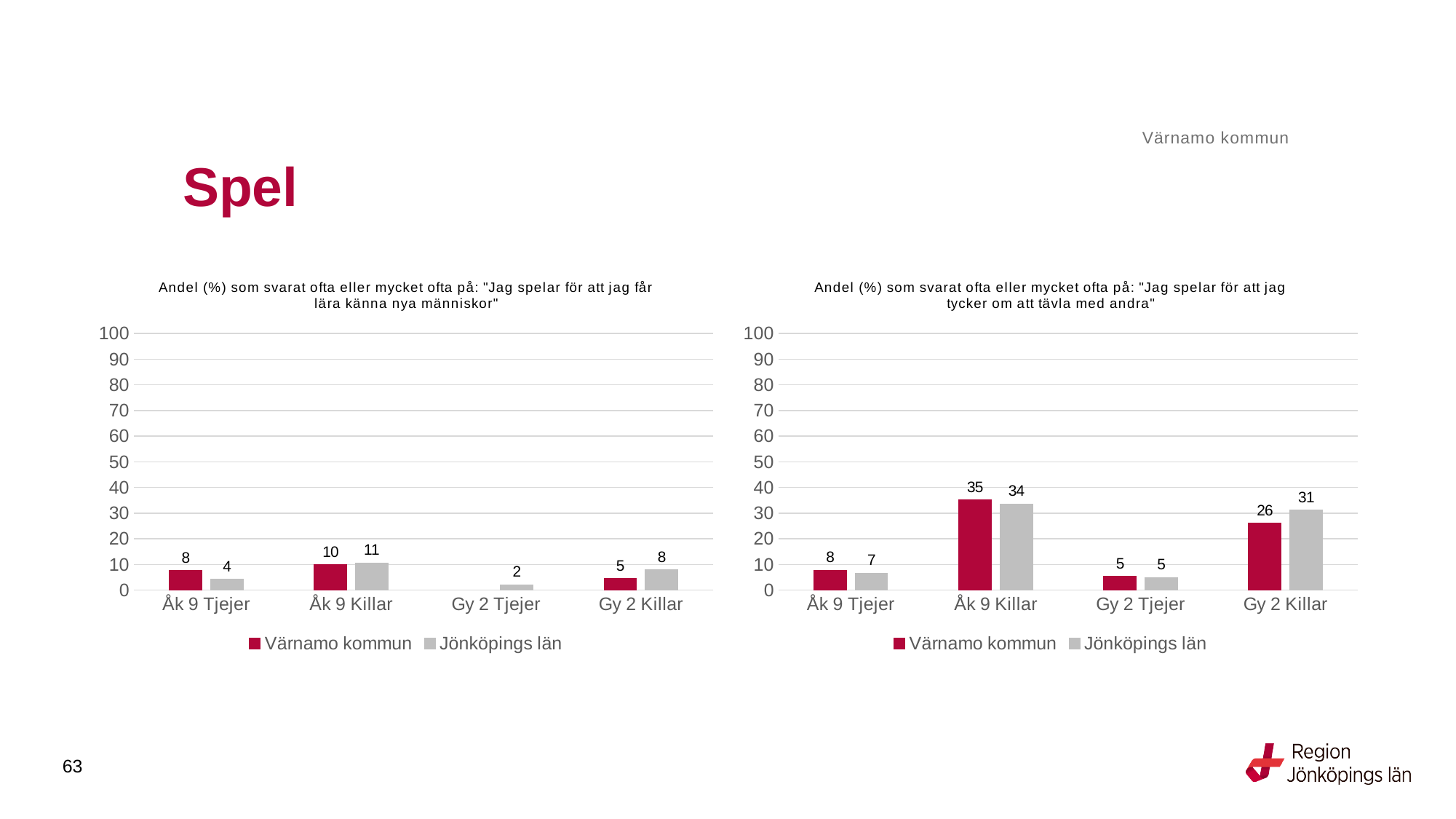
In the left chart ("lära känna nya människor"), what is the value for Jönköpings län for Gy 2 Tjejer? 2 In the right chart ("tävla med andra"), what is the difference between Jönköpings län and Värnamo kommun for Gy 2 Killar? 5 In the left chart ("lära känna nya människor"), what is the value for Värnamo kommun for Åk 9 Tjejer? 8 In the right chart ("tävla med andra"), what is the value for Jönköpings län for Gy 2 Killar? 31 In the left chart ("lära känna nya människor"), which is larger for Åk 9 Tjejer: Värnamo kommun or Jönköpings län? Värnamo kommun In the left chart ("lära känna nya människor"), what is the difference between Värnamo kommun and Jönköpings län for Gy 2 Killar? 3 In the right chart ("tävla med andra"), which category has the lowest value for Värnamo kommun? Gy 2 Tjejer What kind of chart is the left chart? Bar chart How many series does the legend of the right chart list? 2 In the left chart ("lära känna nya människor"), which category has the highest value for Jönköpings län? Åk 9 Killar In the right chart ("tävla med andra"), is the value for Värnamo kommun for Åk 9 Killar greater or less than 30? greater In the right chart ("tävla med andra"), what is the value for Värnamo kommun for Åk 9 Killar? 35